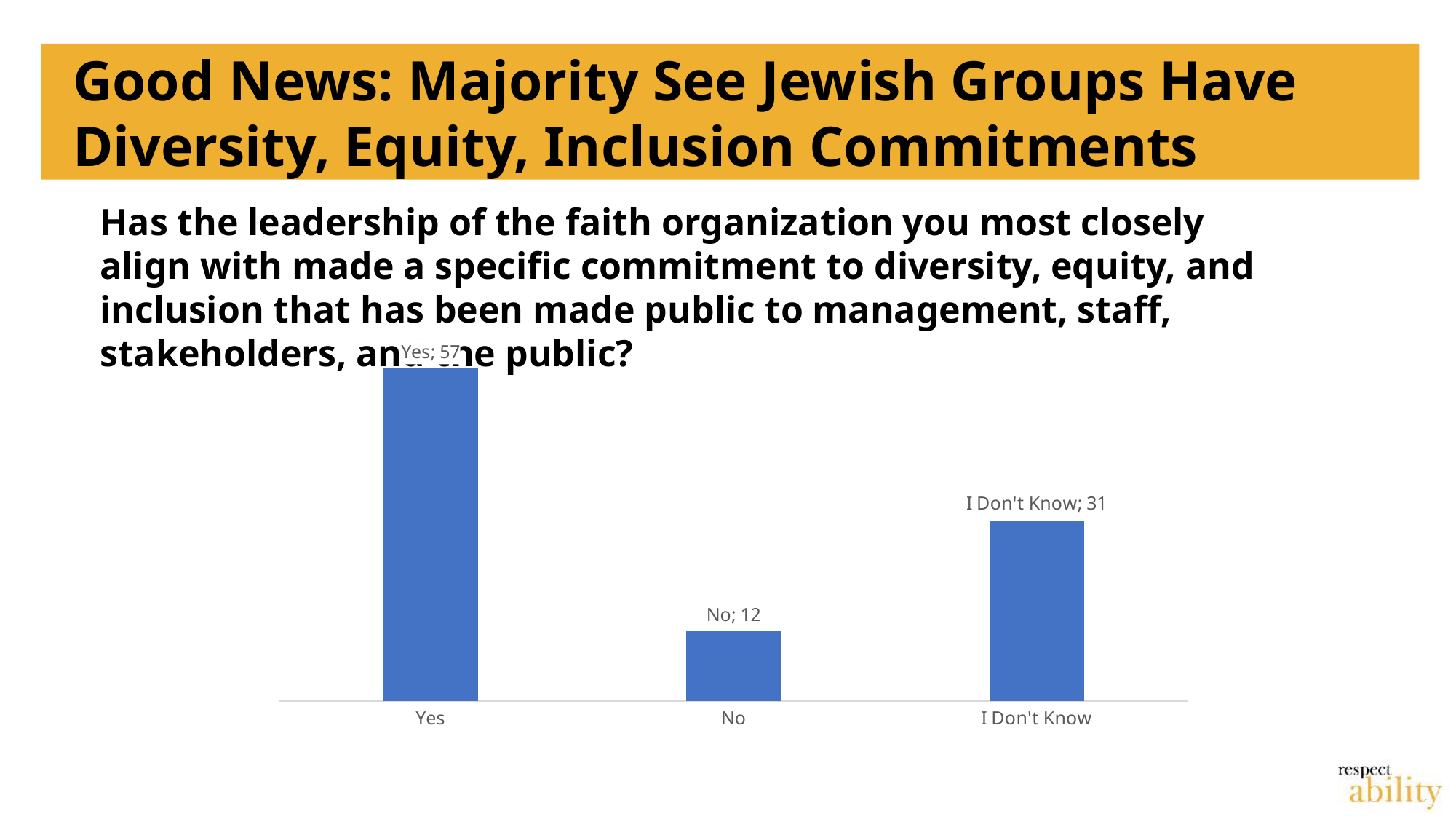
What is the total of the three bar values? 100 How many categories are shown on the chart? 3 Which category has the lowest value? No What is the value for the "I Don't Know" bar? 31 What kind of chart is shown on the slide? Bar chart What colour are the bars in the chart? Blue Which is larger, the value for "I Don't Know" or the value for "No"? I Don't Know Which category has the highest value? Yes What is the difference between the "I Don't Know" value and the "No" value? 19 What is the difference between the "Yes" value and the "No" value? 45 What is the value for the "No" bar? 12 What is the value for the "Yes" bar? 57